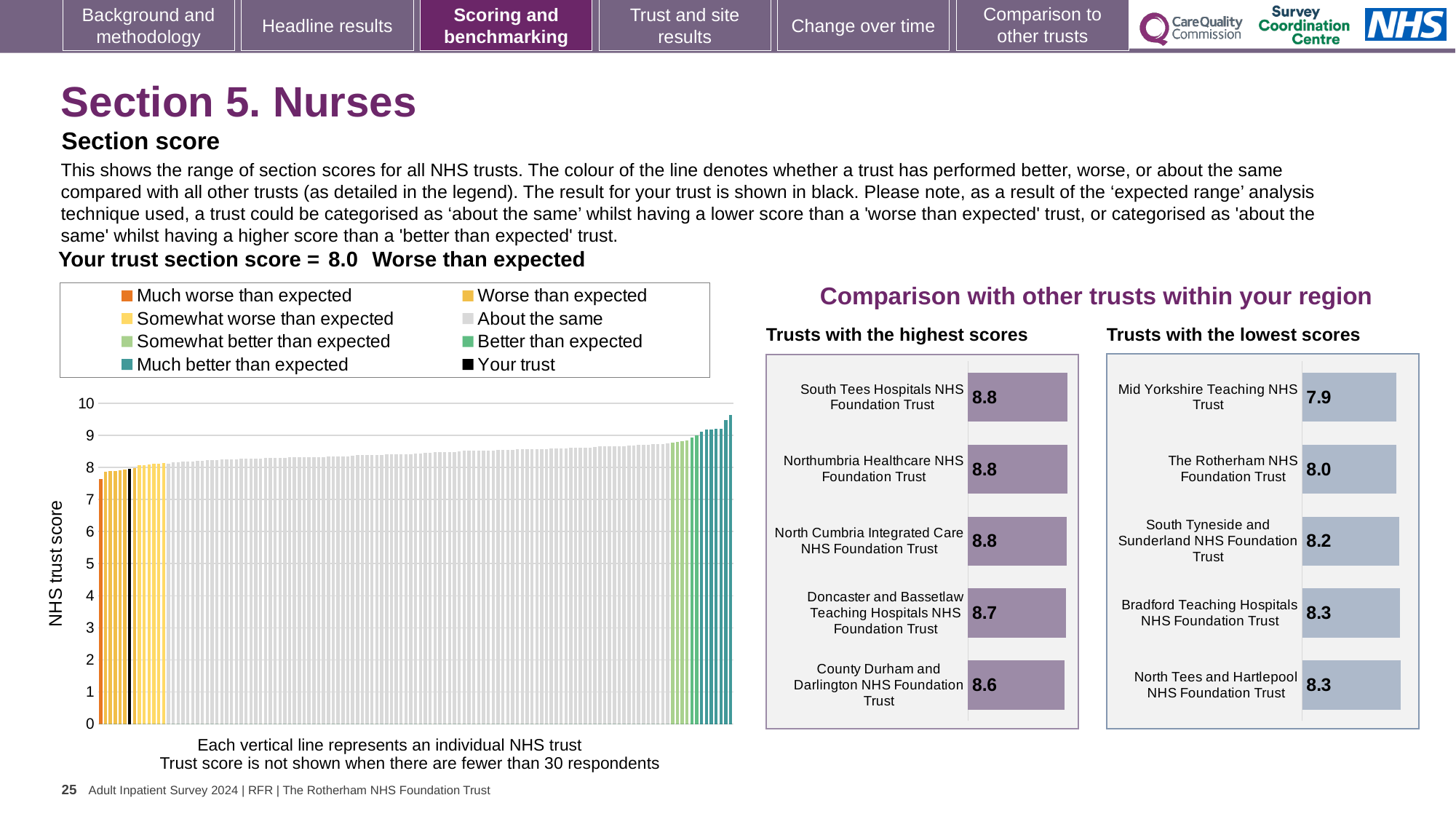
In the 'Trusts with the highest scores' chart, which has the higher score: Doncaster and Bassetlaw Teaching Hospitals NHS Foundation Trust or County Durham and Darlington NHS Foundation Trust? Doncaster and Bassetlaw Teaching Hospitals NHS Foundation Trust In the 'Trusts with the lowest scores' chart, which trust has the lowest score? Mid Yorkshire Teaching NHS Trust In the main chart on the left, do the trust scores rise or fall from left to right along the x axis? rise How many trusts are shown in the 'Trusts with the lowest scores' chart? 5 In the 'Trusts with the highest scores' chart, what is the score for Doncaster and Bassetlaw Teaching Hospitals NHS Foundation Trust? 8.7 In the 'Trusts with the lowest scores' chart, what is the difference between the scores of Bradford Teaching Hospitals NHS Foundation Trust and Mid Yorkshire Teaching NHS Trust? 0.4 How many entries does the legend of the main NHS trust score chart on the left list? 8 In the 'Trusts with the highest scores' chart, what is the difference between the scores of South Tees Hospitals NHS Foundation Trust and County Durham and Darlington NHS Foundation Trust? 0.2 In the 'Trusts with the lowest scores' chart, what is the score for Mid Yorkshire Teaching NHS Trust? 7.9 In the 'Trusts with the highest scores' chart, which trust has the lowest score? County Durham and Darlington NHS Foundation Trust In the 'Trusts with the lowest scores' chart, what is the score for South Tyneside and Sunderland NHS Foundation Trust? 8.2 In the 'Trusts with the highest scores' chart, what is the score for County Durham and Darlington NHS Foundation Trust? 8.6